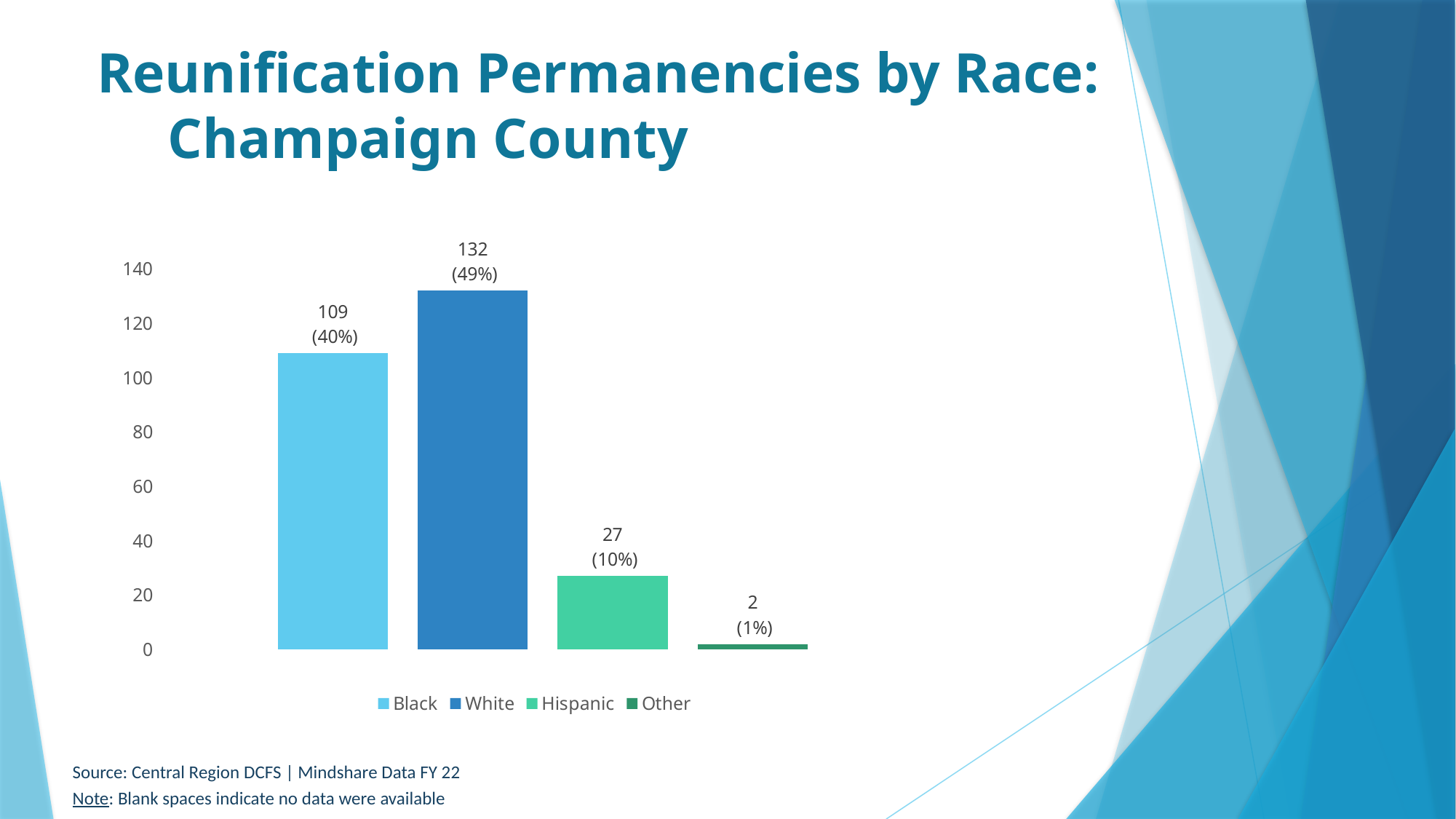
What is the value shown for the Other category? 2 What is the number of reunification permanencies for Black children in Champaign County? 109 What percentage share is shown for Hispanic reunification permanencies? 10% How many race categories are plotted in the chart? 4 What is the source cited for the chart data? Central Region DCFS | Mindshare Data FY 22 What kind of chart is shown on the slide? Bar chart What is the number of reunification permanencies for White children? 132 What is the difference between the White and Black reunification permanency counts? 23 Is the value for Hispanic greater or less than 40? less Which is larger, the value for Black or the value for Hispanic? Black Which race category has the lowest number of reunification permanencies? Other Which race category has the highest number of reunification permanencies? White